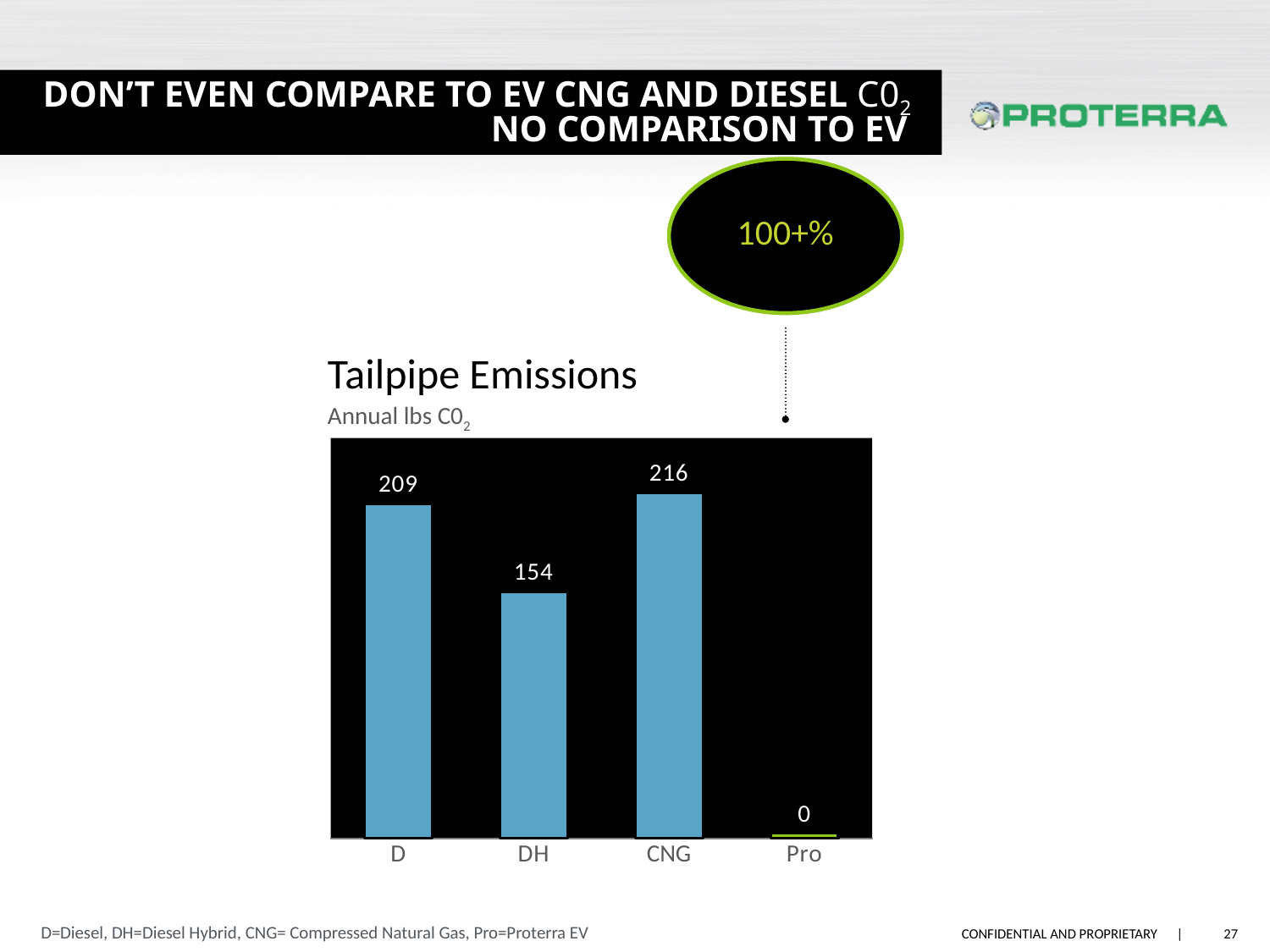
How many categories are shown in the Tailpipe Emissions chart? 4 What is the value for D in the Tailpipe Emissions chart? 209 What kind of chart is the Tailpipe Emissions chart? Bar chart What is the value for Pro in the Tailpipe Emissions chart? 0 Which category has the highest value in the Tailpipe Emissions chart? CNG What is the value for CNG in the Tailpipe Emissions chart? 216 Which category has the lowest value in the Tailpipe Emissions chart? Pro Which is larger in the Tailpipe Emissions chart, the value for D or the value for DH? D What is the value for DH in the Tailpipe Emissions chart? 154 What unit is given in the subtitle of the Tailpipe Emissions chart? Annual lbs CO2 What is the difference between the values for CNG and DH in the Tailpipe Emissions chart? 62 What is the difference between the values for D and DH in the Tailpipe Emissions chart? 55